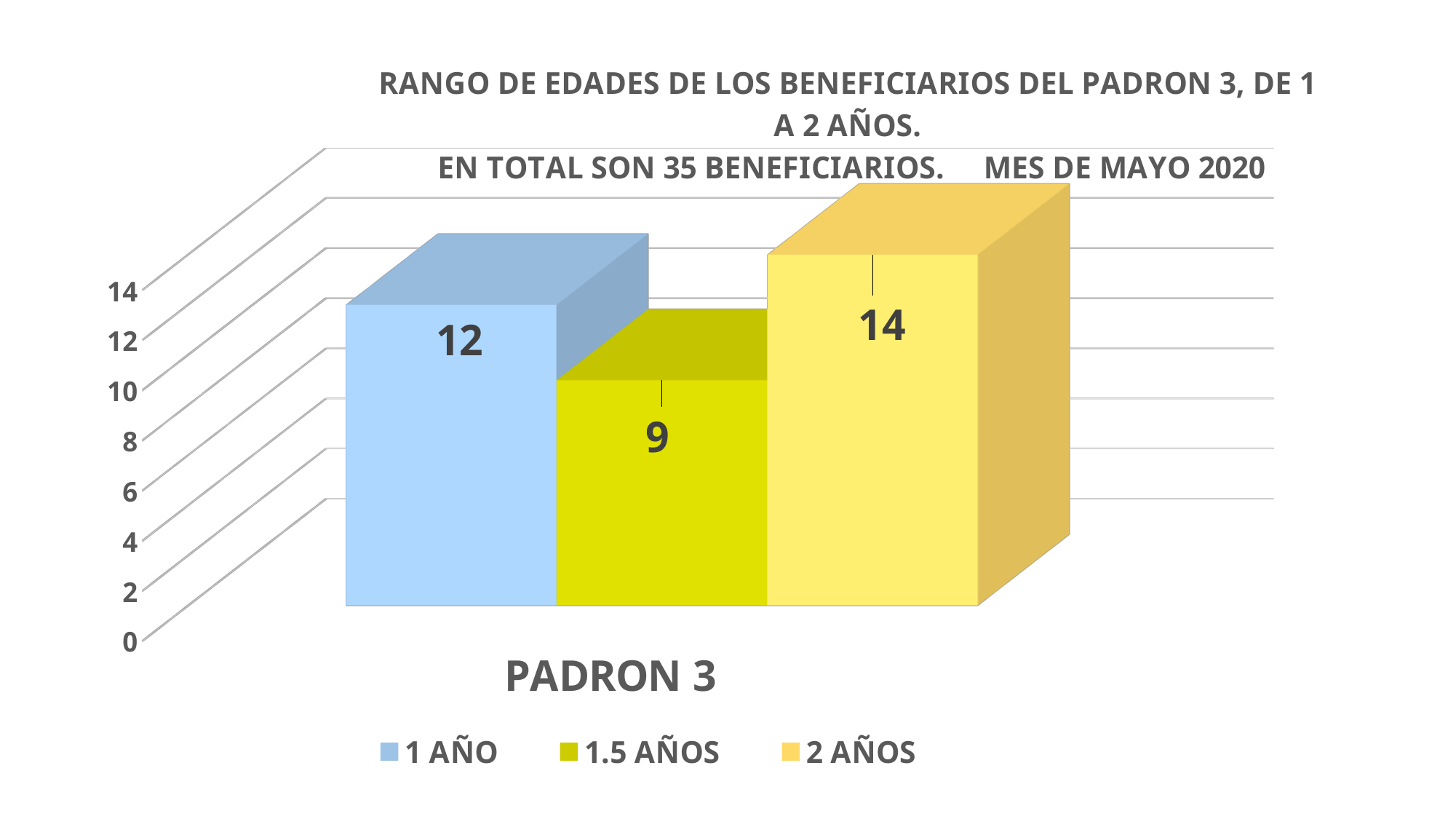
What is the value for the 2 AÑOS series? 14 What is the category label shown on the x axis? PADRON 3 What is the value for the 1 AÑO series? 12 Which series has the highest value? 2 AÑOS Which series has the lowest value? 1.5 AÑOS How many series does the legend list? 3 What colour is the bar for the 2 AÑOS series? Yellow What is the difference between the values for 2 AÑOS and 1 AÑO? 2 What is the value for the 1.5 AÑOS series? 9 Which is larger, the value for 1 AÑO or the value for 1.5 AÑOS? 1 AÑO What kind of chart is shown on the slide? Bar chart What is the difference between the values for 2 AÑOS and 1.5 AÑOS? 5